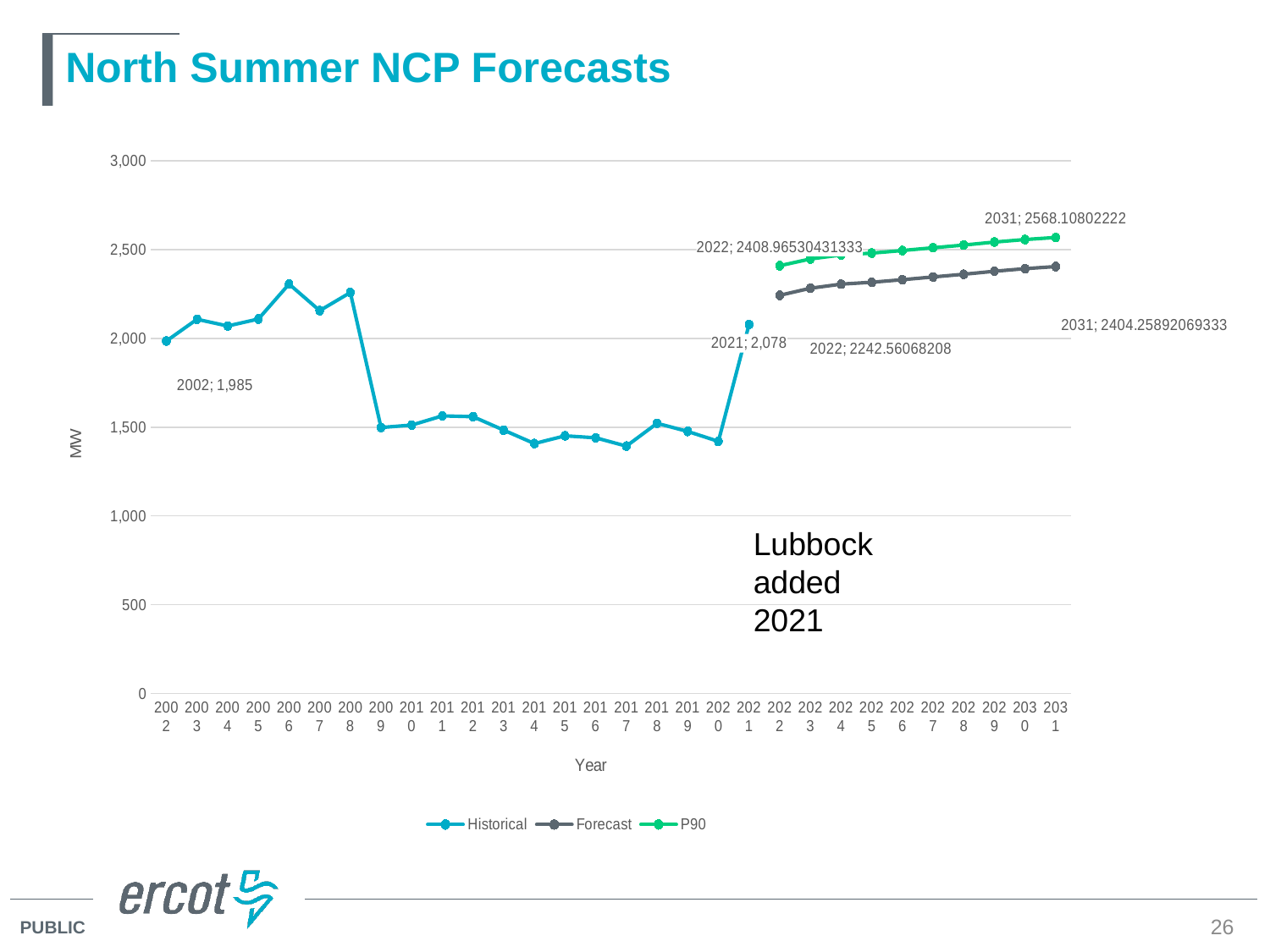
What is the Historical value for 2021? 2,078 Which is larger in 2031, the P90 value or the Forecast value? P90 What is the P90 value for 2022? 2408.96530431333 Is the Historical value for 2009 greater or less than 2,000? less What kind of chart is shown on the slide? line chart Does the Forecast series rise or fall from 2022 to 2031? rise What is the P90 value for 2031? 2568.10802222 What is the Forecast value for 2031? 2404.25892069333 How many series does the legend list? 3 What is the Forecast value for 2022? 2242.56068208 What is the Historical value for 2002? 1,985 By how much does the Historical value for 2021 exceed the Historical value for 2002? 93